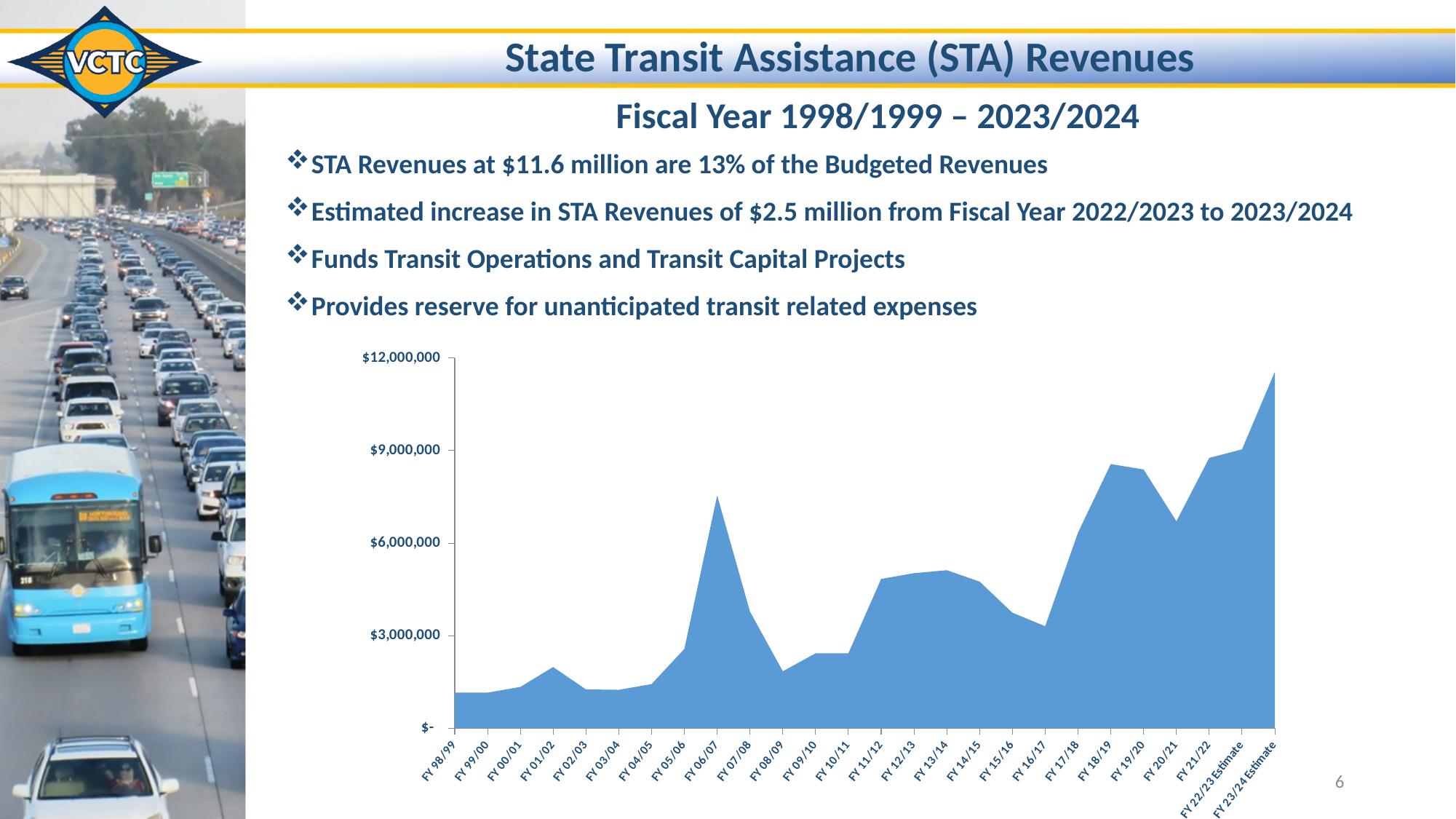
Is the value for FY 18/19 greater or less than $6,000,000? greater Is the value for FY 08/09 greater or less than $3,000,000? less Overall, do STA revenues rise or fall from FY 98/99 to FY 23/24 Estimate? Rise Which fiscal year has the larger value, FY 01/02 or FY 11/12? FY 11/12 Is the value for FY 13/14 greater or less than $6,000,000? less What kind of chart is shown on the slide? Area chart Which fiscal year has the highest STA revenue in the chart? FY 23/24 Estimate How many fiscal years are plotted along the x axis of the chart? 26 Which fiscal year has the larger value, FY 06/07 or FY 18/19? FY 18/19 What is the highest value labelled on the chart's y axis? $12,000,000